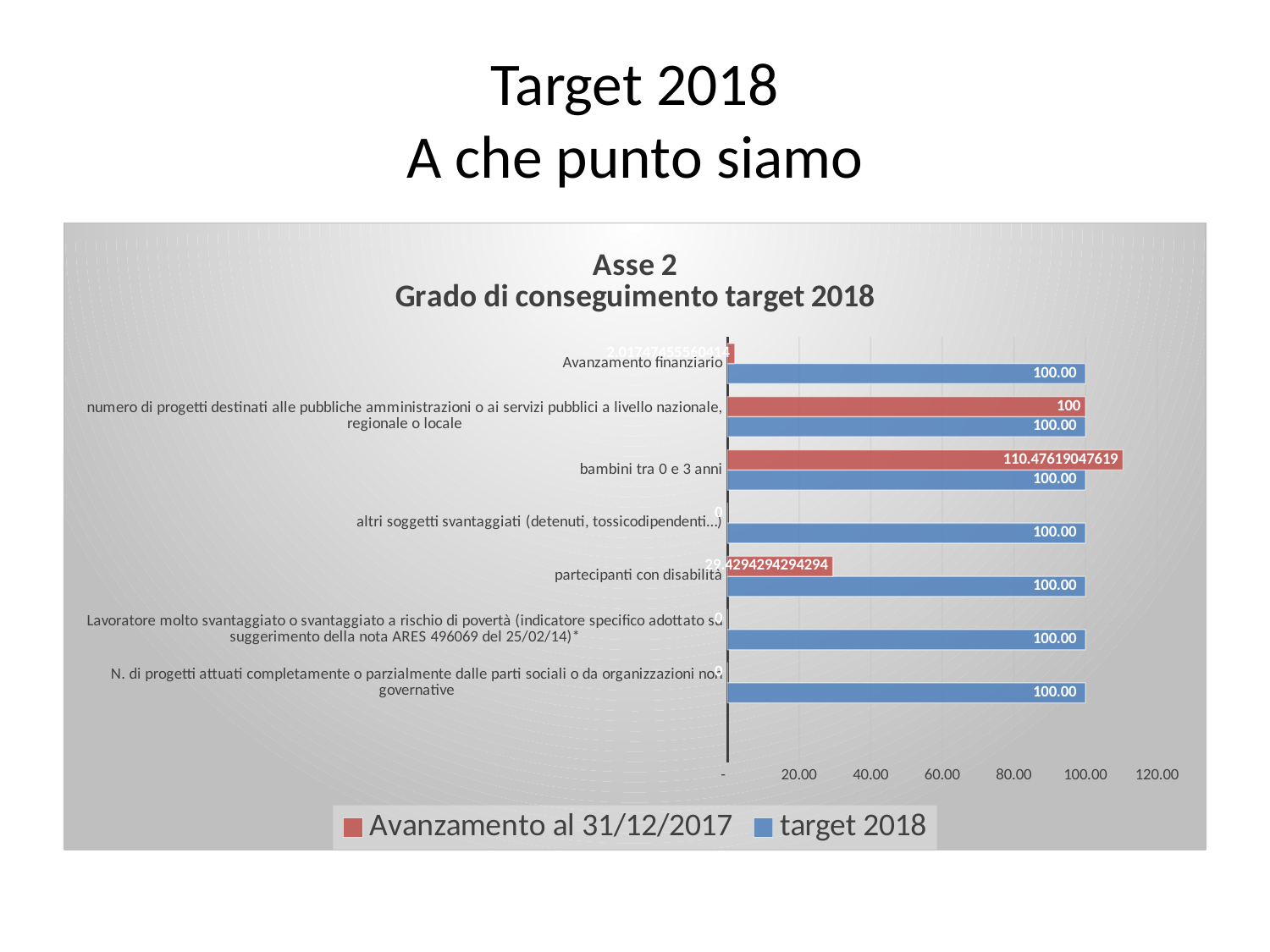
Is the 'Avanzamento al 31/12/2017' value for 'partecipanti con disabilità' greater or less than 40.00? less Is the 'Avanzamento al 31/12/2017' value for 'Avanzamento finanziario' greater or less than 20.00? less By how much does the 'Avanzamento al 31/12/2017' value for 'bambini tra 0 e 3 anni' exceed its 'target 2018' value? 10.47619047619 What is the 'target 2018' value for 'partecipanti con disabilità'? 100.00 What is the 'Avanzamento al 31/12/2017' value for 'altri soggetti svantaggiati (detenuti, tossicodipendenti...)'? 0 How many categories are plotted on the chart? 7 What is the title of the chart? Asse 2 Grado di conseguimento target 2018 Which category has the highest 'Avanzamento al 31/12/2017' value? bambini tra 0 e 3 anni What kind of chart is shown on the slide? bar chart How many series does the legend of the chart list? 2 Which has the larger 'Avanzamento al 31/12/2017' value: 'bambini tra 0 e 3 anni' or 'numero di progetti destinati alle pubbliche amministrazioni o ai servizi pubblici a livello nazionale, regionale o locale'? bambini tra 0 e 3 anni What is the value of 'Avanzamento al 31/12/2017' for 'bambini tra 0 e 3 anni'? 110.47619047619